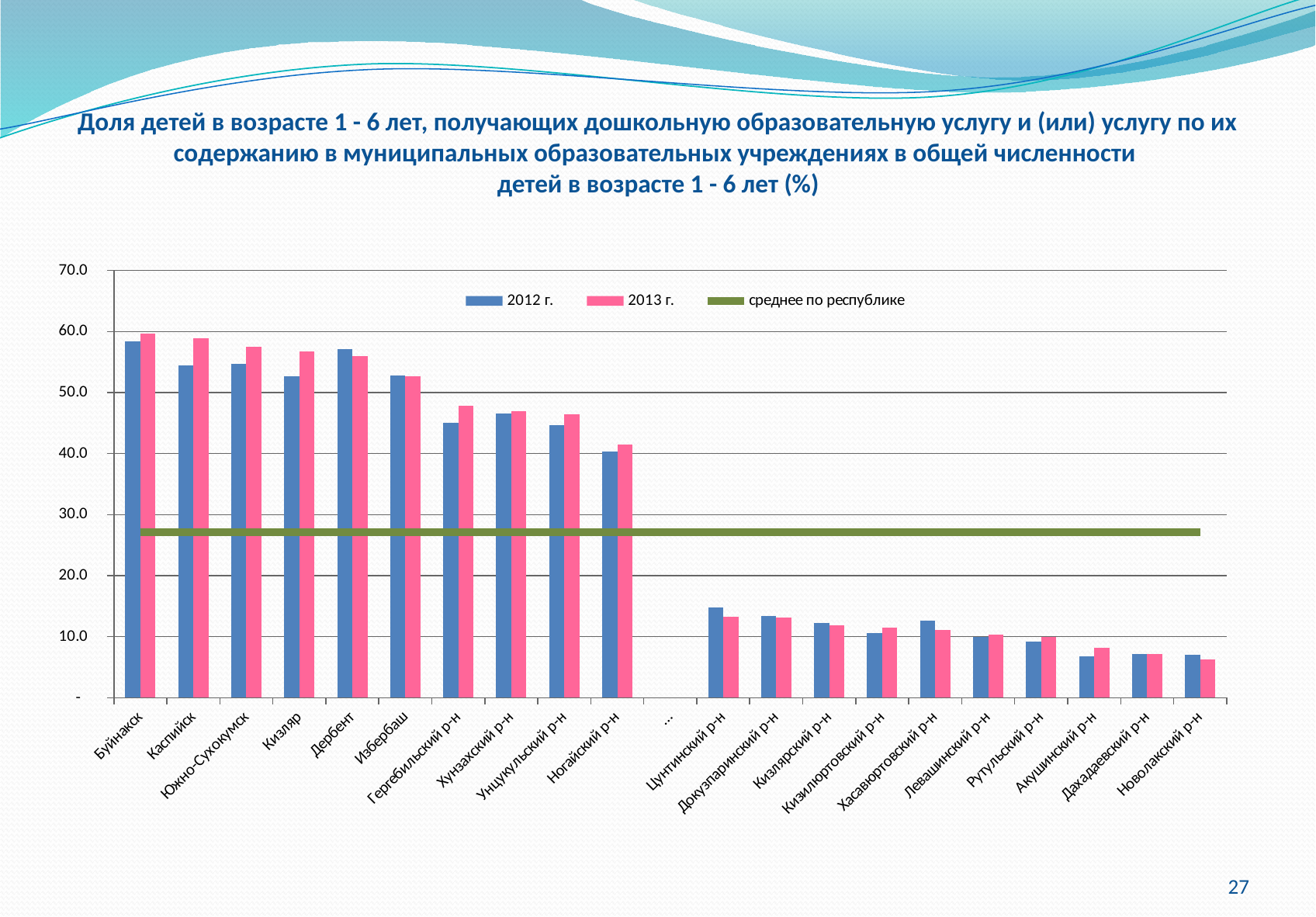
Do the values generally rise or fall moving from left to right along the x axis? fall Which has the larger 2012 г. value: Буйнакск or Цунтинский р-н? Буйнакск What kind of chart is shown on the slide? combination bar and line chart Is the value for Ногайский р-н in 2012 г. greater or less than 30? greater Is the value for Буйнакск in 2012 г. greater or less than 50? greater What does the green horizontal line in the chart represent, according to the legend? среднее по республике Is the value for Новолакский р-н in 2013 г. greater or less than 10? less How many series does the legend list? 3 Which is larger for Каспийск: the 2012 г. value or the 2013 г. value? 2013 г. Which is larger for Кизляр: the 2012 г. value or the 2013 г. value? 2013 г.